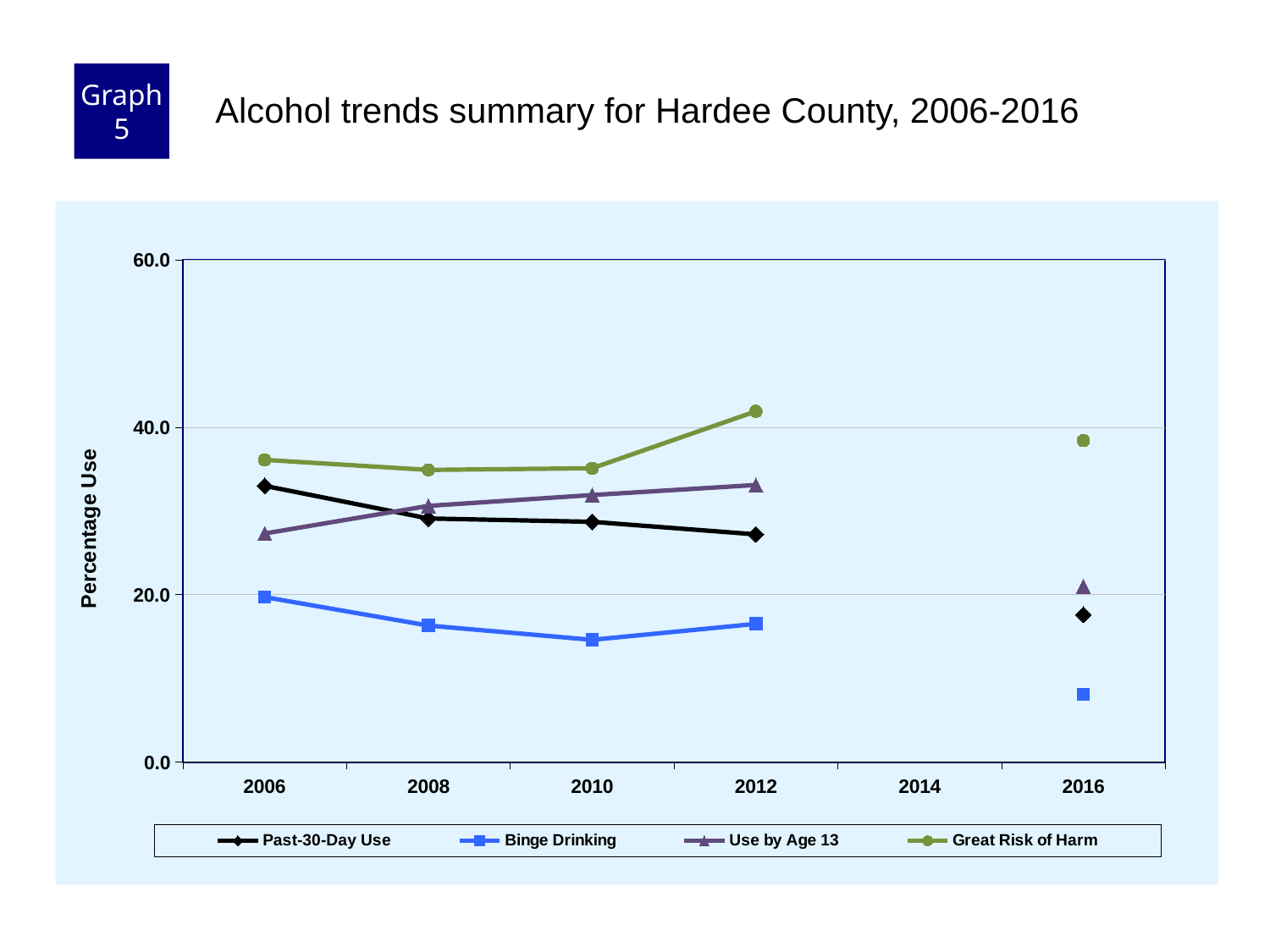
What is the title of the y axis? Percentage Use How many series does the legend list? 4 In 2012, which is higher: Use by Age 13 or Past-30-Day Use? Use by Age 13 In 2006, which is higher: Past-30-Day Use or Use by Age 13? Past-30-Day Use Is the value for Past-30-Day Use in 2016 greater or less than 20.0? less How many years are labelled on the x axis? 6 Does the Use by Age 13 series rise or fall from 2006 to 2012? rise Which series has the lowest value in 2016? Binge Drinking What kind of chart is shown on the slide? line chart Is the value for Binge Drinking in 2016 greater or less than 20.0? less Which series has the highest value in 2012? Great Risk of Harm Is the value for Great Risk of Harm in 2012 greater or less than 40.0? greater